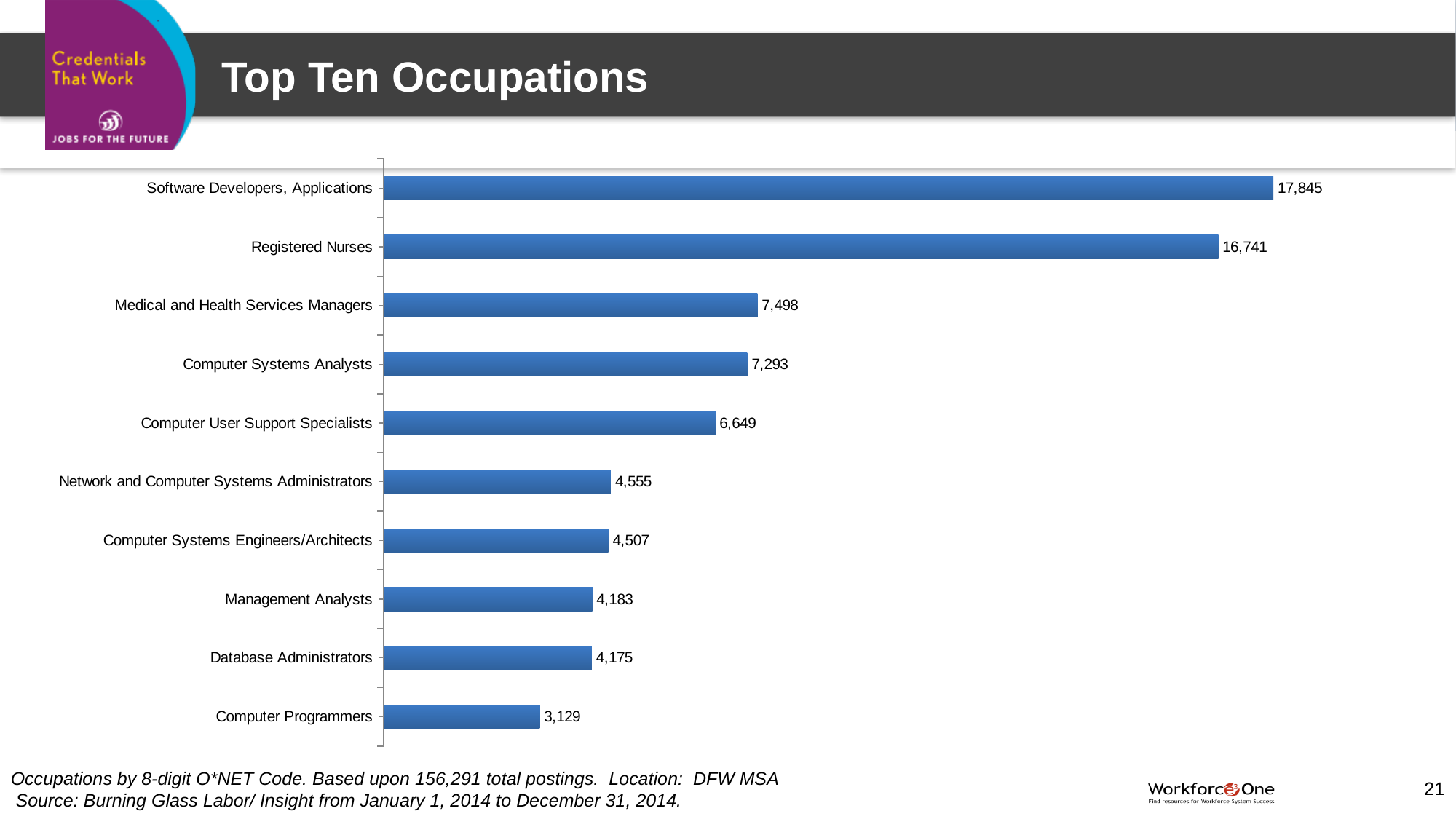
What is the difference between Medical and Health Services Managers and Computer Systems Analysts? 205 What is the value for Computer User Support Specialists? 6,649 What kind of chart is shown on the slide? Bar chart What is the value for Database Administrators? 4,175 How many occupations are shown in the chart? 10 What is the difference between Software Developers, Applications and Registered Nurses? 1,104 What is the title of the slide? Top Ten Occupations Which occupation has the lowest value? Computer Programmers Which is larger, Computer Programmers or Computer Systems Engineers/Architects? Computer Systems Engineers/Architects What is the value for Registered Nurses? 16,741 Which is larger, Network and Computer Systems Administrators or Management Analysts? Network and Computer Systems Administrators Which occupation has the highest value? Software Developers, Applications